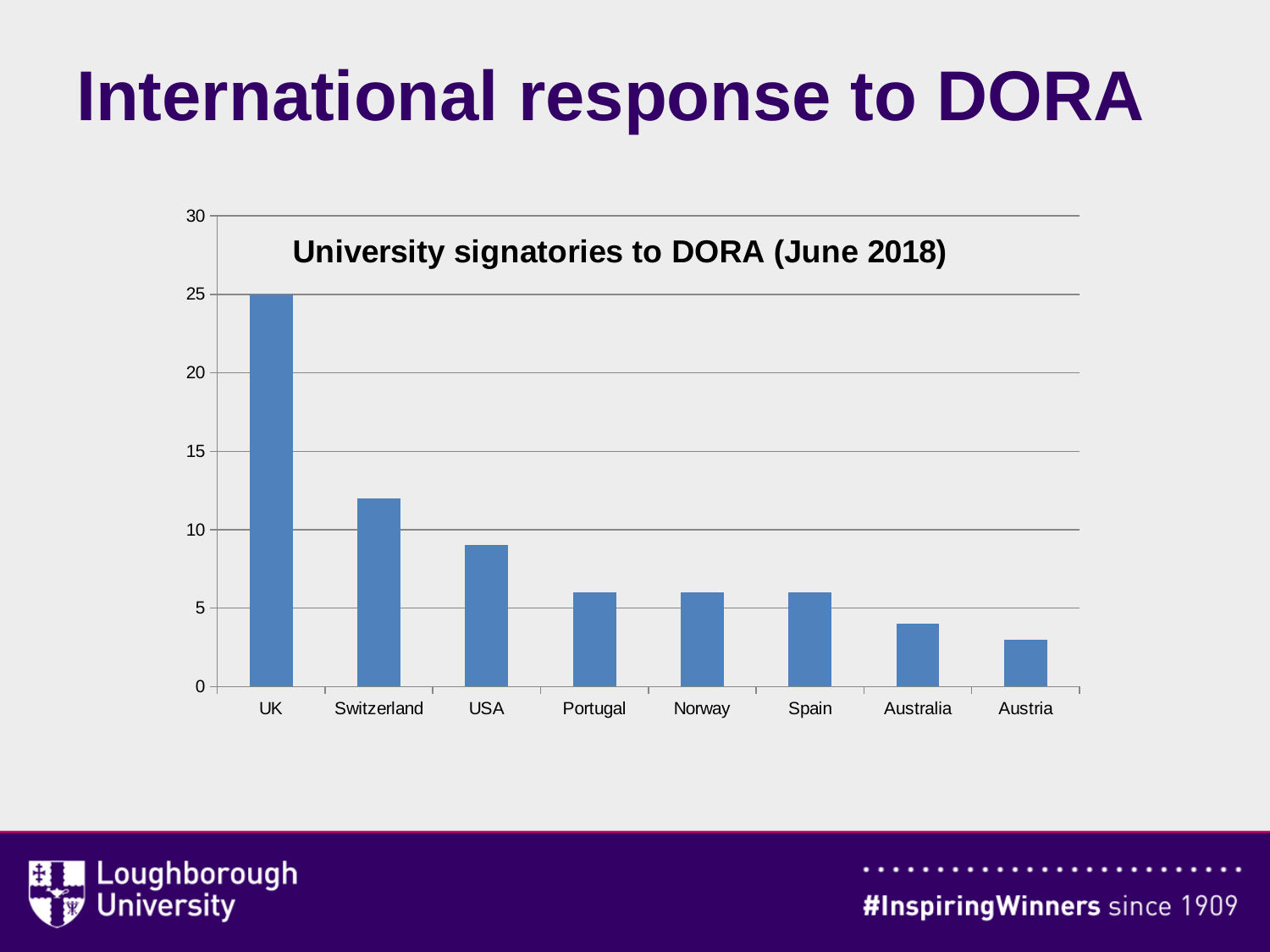
Is the value for USA greater or less than 10? less Is the value for Switzerland greater or less than 10? greater Which country has the highest number of university signatories to DORA? UK How many university signatories to DORA does the UK have? 25 What is the title of the chart? University signatories to DORA (June 2018) Which has more university signatories to DORA, Switzerland or USA? Switzerland What kind of chart is shown on the slide? bar chart How many countries are shown on the x axis of the chart? 8 Is the value for Portugal greater or less than 5? greater Do the values rise or fall moving from left to right along the x axis? fall Which country has the lowest number of university signatories to DORA? Austria